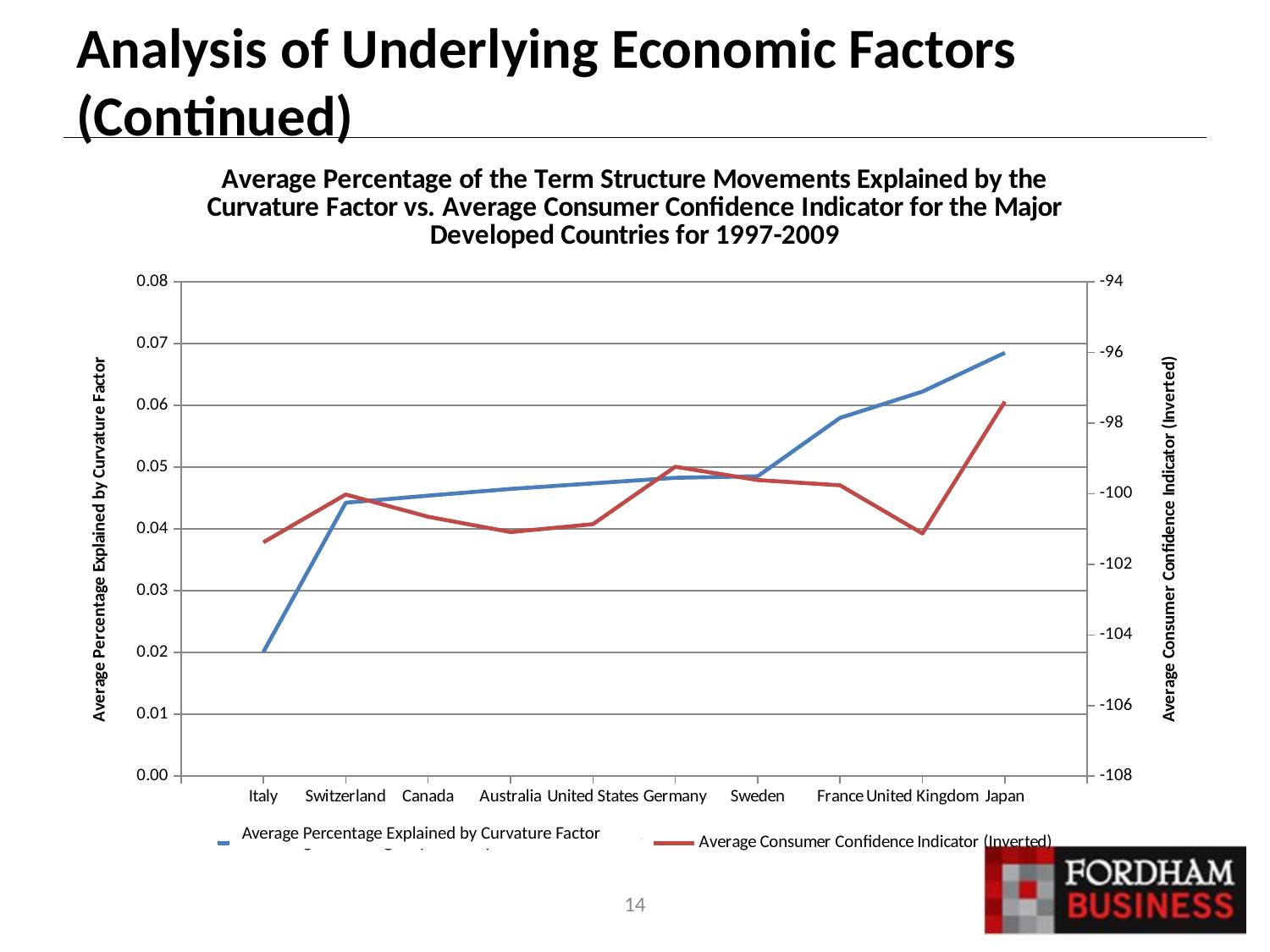
Is the Average Percentage Explained by Curvature Factor for Japan greater or less than 0.06? greater Which country has the highest Average Percentage Explained by Curvature Factor? Japan What kind of chart is shown on the slide? line chart How many countries are plotted along the x axis? 10 Is the Average Percentage Explained by Curvature Factor for France greater or less than 0.05? greater Is the Average Percentage Explained by Curvature Factor for Italy greater or less than 0.03? less What colour is the line for Average Consumer Confidence Indicator (Inverted)? red Does the Average Percentage Explained by Curvature Factor generally rise or fall from Italy to Japan? rise Which country has the lowest Average Percentage Explained by Curvature Factor? Italy Which has the higher Average Percentage Explained by Curvature Factor, France or Sweden? France How many series does the legend list? 2